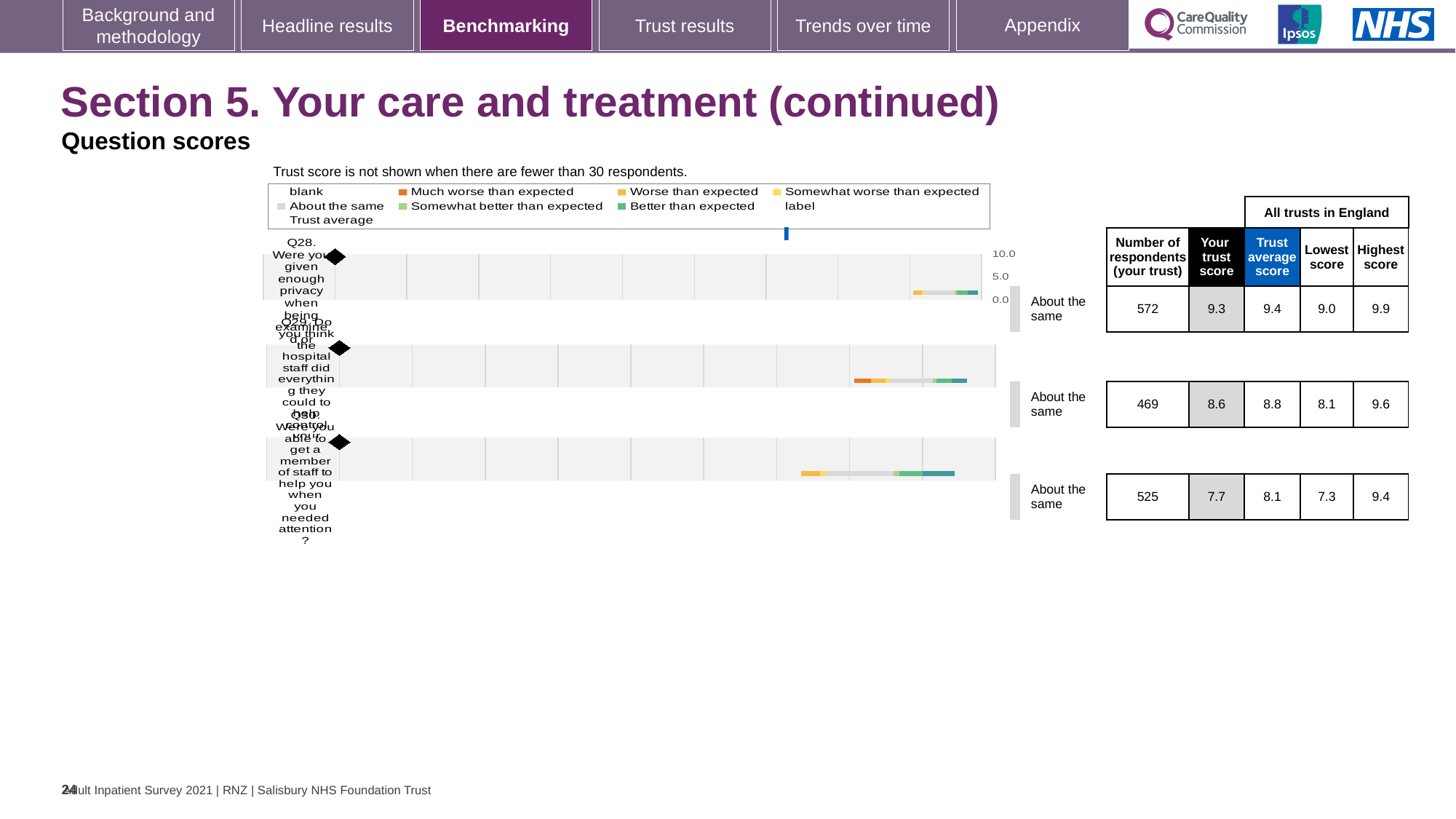
What is the trust average score for Q30? 8.1 Which question has the highest 'Your trust score' on this slide? Q28 How many questions are shown in the benchmarking charts on this slide? 3 Which question has the lowest 'Your trust score' on this slide? Q30 What is the lowest score across all trusts in England for Q30? 7.3 What is the 'Your trust score' for Q28 (Were you given enough privacy when being examined or treated?)? 9.3 What benchmark category is shown for Q30? About the same What is the highest score across all trusts in England for Q28? 9.9 For Q29, which is larger: your trust score or the trust average score? Trust average score What is the difference between the highest and lowest scores across all trusts in England for Q29? 1.5 How many respondents from your trust answered Q29? 469 What is the difference between the trust average score and your trust score for Q28? 0.1